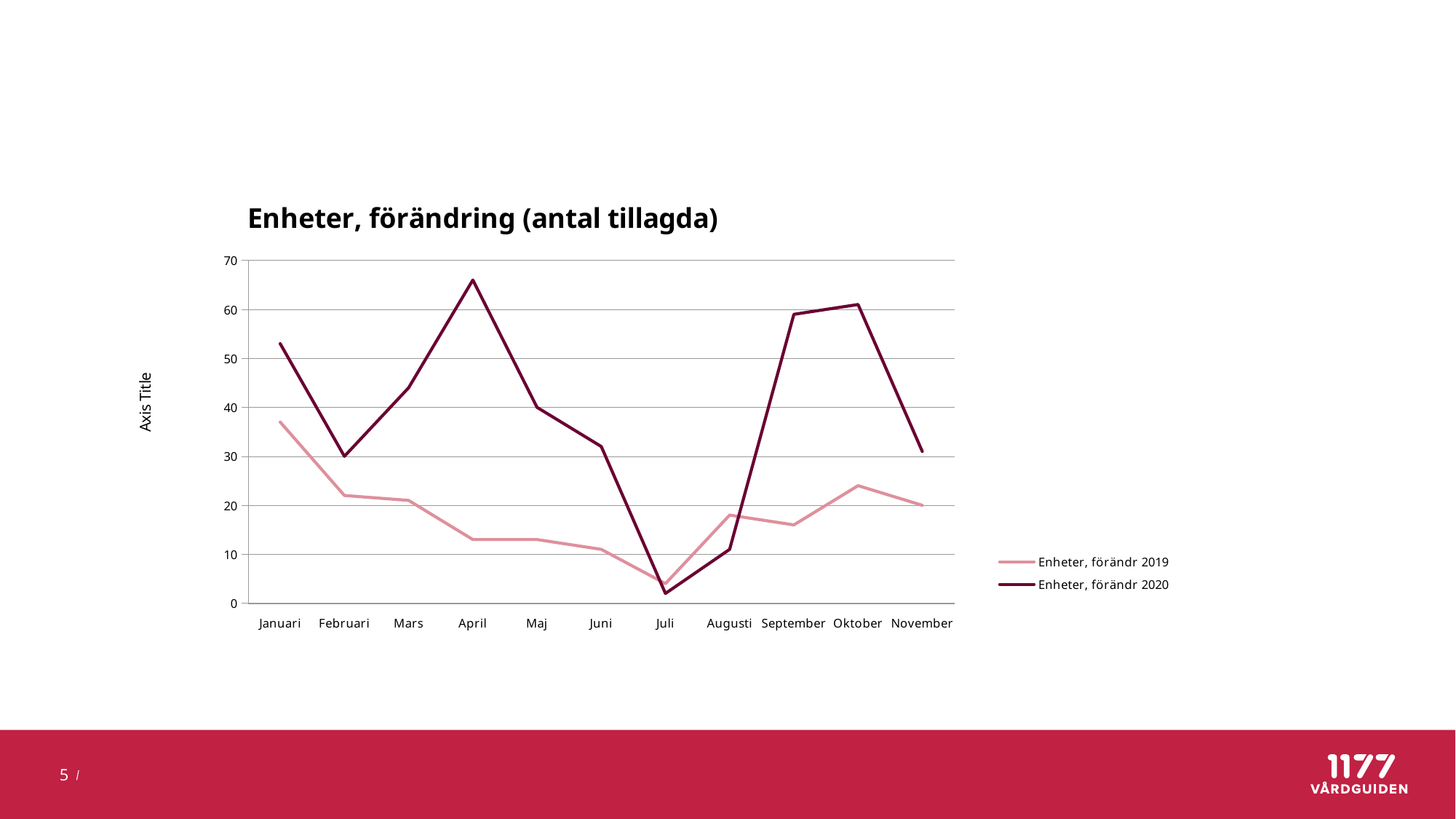
In Augusti, which series has the larger value, 'Enheter, förändr 2019' or 'Enheter, förändr 2020'? Enheter, förändr 2019 How many series does the legend list? 2 What kind of chart is shown on the slide? line chart Is the value for 'Enheter, förändr 2020' in April greater or less than 60? greater Is the value for 'Enheter, förändr 2020' in Juli greater or less than 10? less How many months are shown on the x axis? 11 What is the title of the chart? Enheter, förändring (antal tillagda) Is the value for 'Enheter, förändr 2019' in Januari greater or less than 30? greater Does the series 'Enheter, förändr 2019' rise or fall from Januari to Juli? fall In which month does the series 'Enheter, förändr 2020' reach its lowest value? Juli In which month does the series 'Enheter, förändr 2020' reach its highest value? April In which month does the series 'Enheter, förändr 2019' reach its highest value? Januari